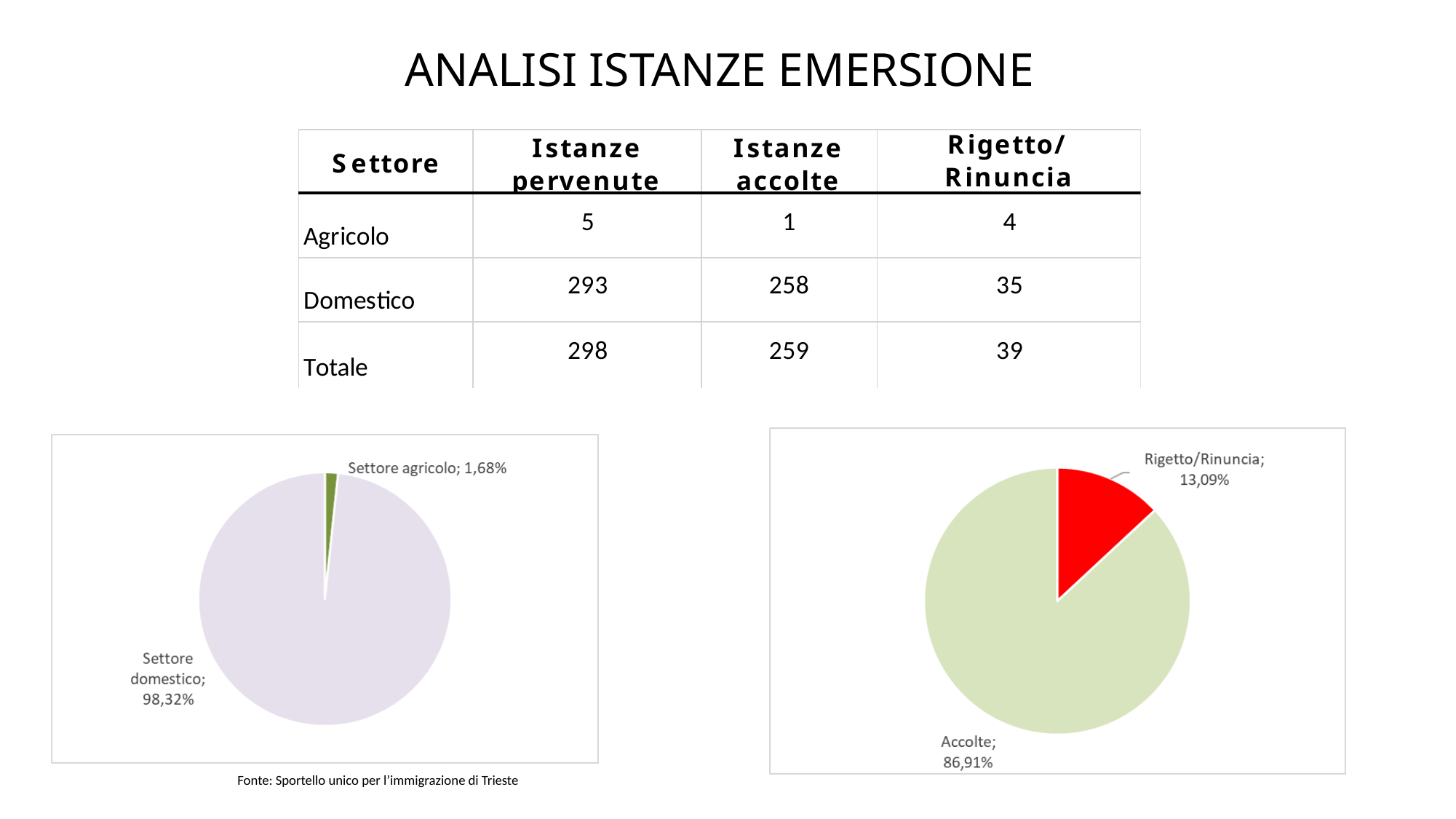
In the pie chart on the right, which is larger, Accolte or Rigetto/Rinuncia? Accolte In the pie chart on the right, which slice is the smallest? Rigetto/Rinuncia In the pie chart on the left, what colour is the Settore agricolo slice? Green What kind of chart is the chart on the left? Pie chart In the pie chart on the right, what colour is the Rigetto/Rinuncia slice? Red In the pie chart on the left, what share does Settore agricolo have? 1,68% In the pie chart on the left, what share does Settore domestico have? 98,32% How many slices does the pie chart on the right have? 2 In the pie chart on the right, what share does Accolte have? 86,91% In the pie chart on the left, which slice is the largest? Settore domestico In the pie chart on the right, what is the difference between the Accolte share and the Rigetto/Rinuncia share? 73,82%